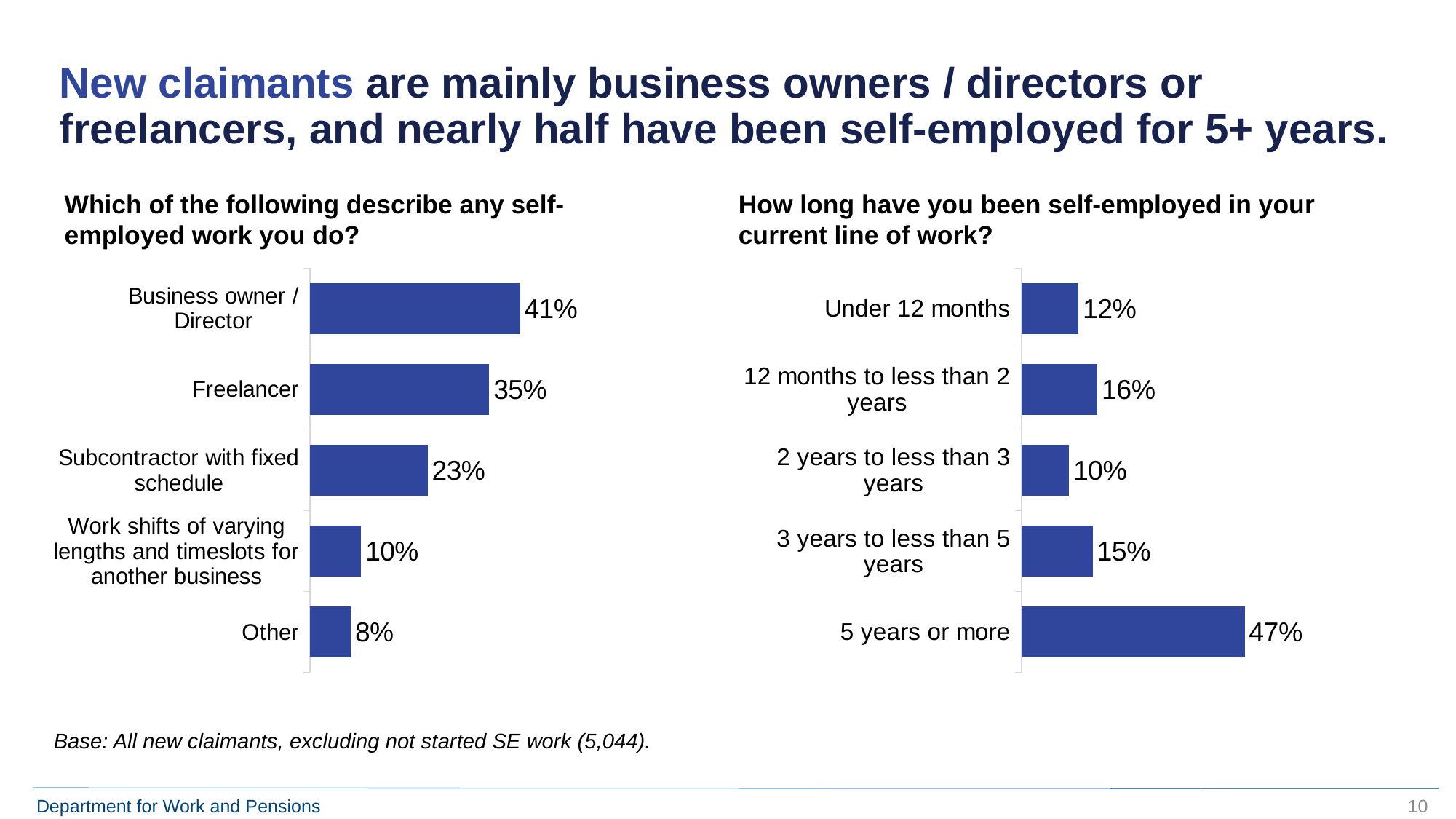
In the left chart (Which of the following describe any self-employed work you do?), what is the value for Subcontractor with fixed schedule? 23% What kind of chart is the right chart (How long have you been self-employed in your current line of work?)? Bar chart In the right chart (How long have you been self-employed in your current line of work?), which is larger: Under 12 months or 12 months to less than 2 years? 12 months to less than 2 years In the right chart (How long have you been self-employed in your current line of work?), which category has the highest value? 5 years or more In the left chart (Which of the following describe any self-employed work you do?), which category has the highest value? Business owner / Director In the left chart (Which of the following describe any self-employed work you do?), which category has the lowest value? Other In the right chart (How long have you been self-employed in your current line of work?), which category has the lowest value? 2 years to less than 3 years In the left chart (Which of the following describe any self-employed work you do?), how many categories are shown? 5 In the right chart (How long have you been self-employed in your current line of work?), what is the value for 3 years to less than 5 years? 15% In the left chart (Which of the following describe any self-employed work you do?), what is the difference between Business owner / Director and Freelancer? 6% In the right chart (How long have you been self-employed in your current line of work?), what is the difference between 5 years or more and Under 12 months? 35% In the left chart (Which of the following describe any self-employed work you do?), what is the value for Freelancer? 35%